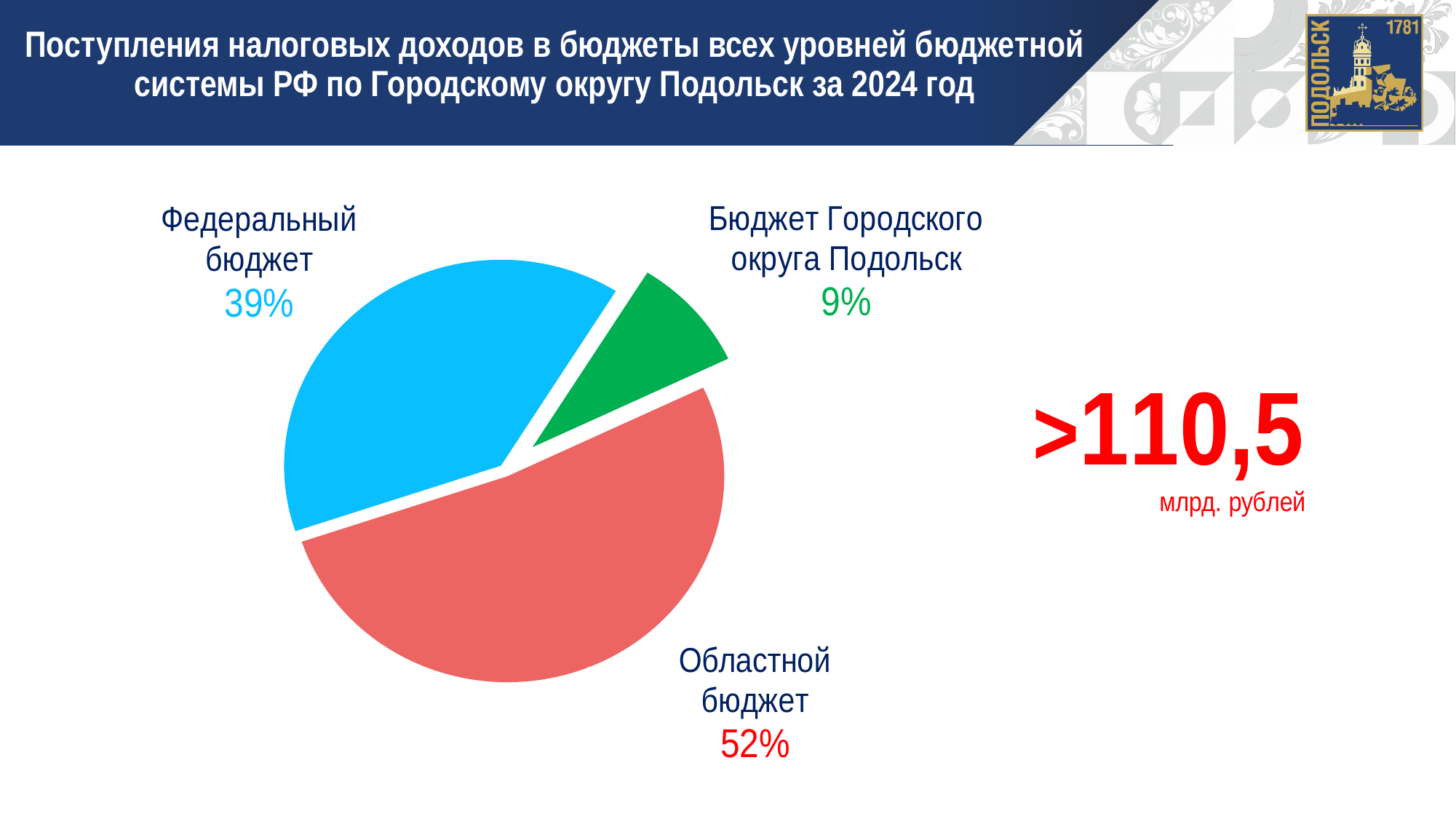
What share of the pie does Областной бюджет have? 52% What is the difference in percentage points between Федеральный бюджет and Бюджет Городского округа Подольск? 30 Which slice of the pie is the smallest? Бюджет Городского округа Подольск What share of the pie does Бюджет Городского округа Подольск have? 9% How many slices does the pie chart have? 3 Which slice of the pie is the largest? Областной бюджет What total amount in billions of rubles is shown next to the pie chart? >110,5 млрд. рублей Which is larger: the share of Федеральный бюджет or the share of Бюджет Городского округа Подольск? Федеральный бюджет What is the difference in percentage points between Областной бюджет and Федеральный бюджет? 13 What share of the pie does Федеральный бюджет have? 39% What type of chart is shown on the slide? pie chart What colour is the slice for Областной бюджет? red